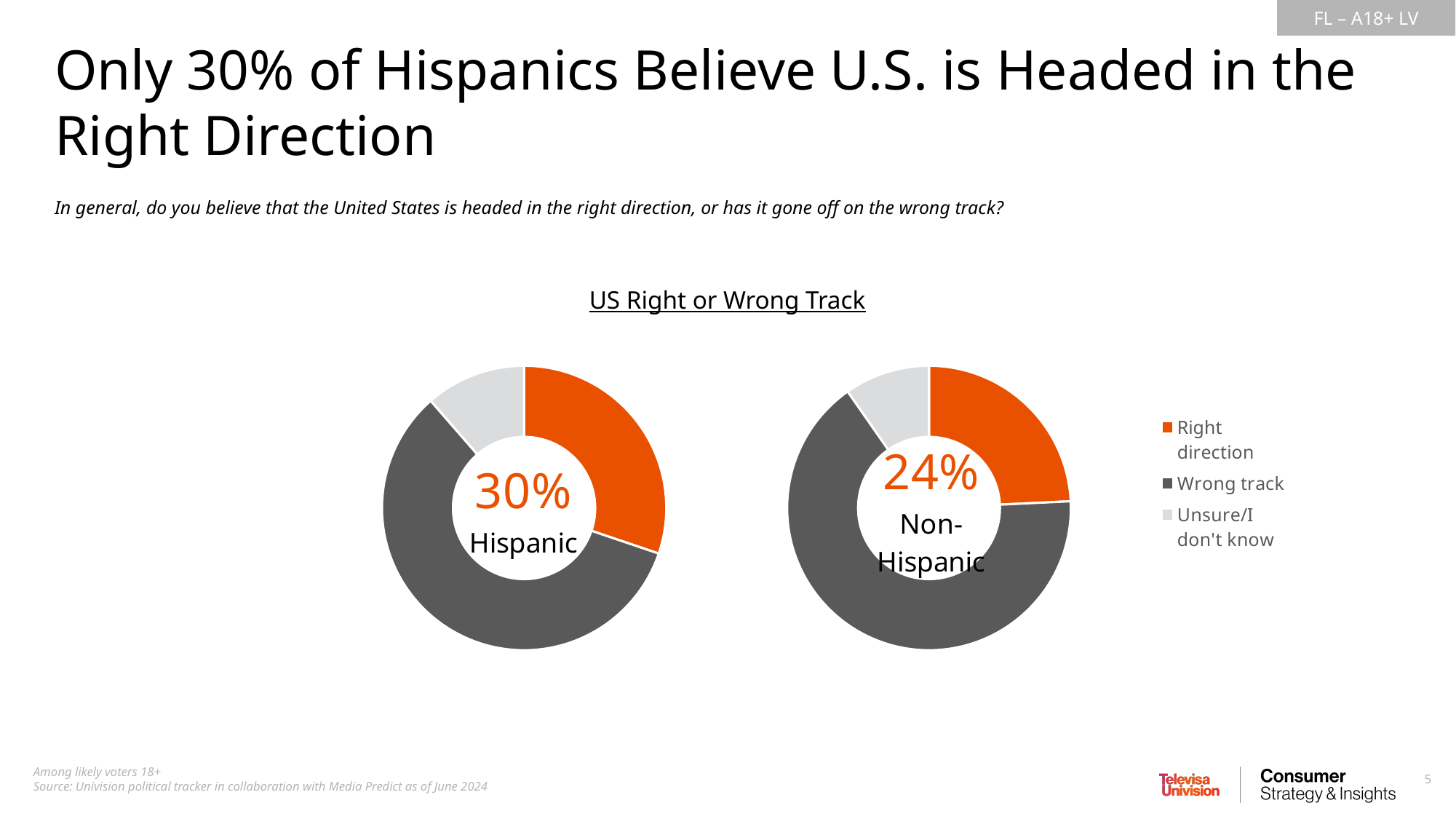
What is the title shown above the two donut charts? US Right or Wrong Track How many response categories does the legend list for the US Right or Wrong Track charts? 3 How many percentage points higher is the Hispanic 'right direction' share than the Non-Hispanic 'right direction' share? 6 percentage points In the Non-Hispanic donut chart, which response category takes up the largest slice? Wrong track In the Hispanic donut chart, what share of respondents say the U.S. is headed in the right direction? 30% In the Non-Hispanic donut chart, which response category takes up the smallest slice? Unsure/I don't know In the Non-Hispanic donut chart, what share of respondents say the U.S. is headed in the right direction? 24% What kind of chart is used to show the US Right or Wrong Track results? Donut (pie) chart How many donut charts are shown on the slide? 2 Which colour represents 'Wrong track' in the donut charts? Dark grey Which group has the larger share saying the U.S. is headed in the right direction, Hispanic or Non-Hispanic? Hispanic In the Hispanic donut chart, which response category takes up the largest slice? Wrong track